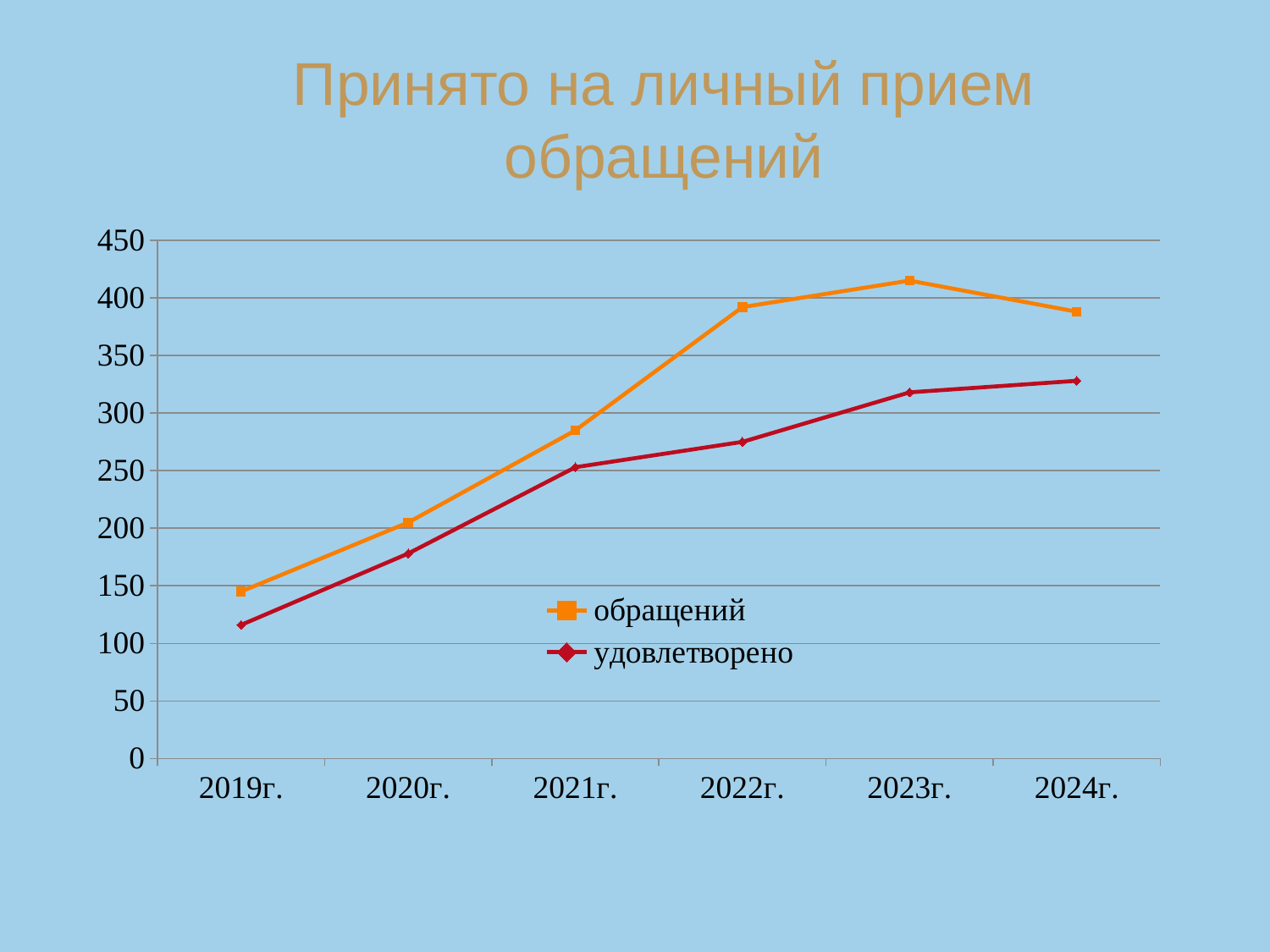
In which year is the value for удовлетворено lowest? 2019г. Does the value for удовлетворено rise or fall from 2019г. to 2024г.? rise What is the title of the chart? Принято на личный прием обращений Is the value for удовлетворено in 2024г. greater or less than 300? greater Is the value for обращений in 2022г. greater or less than 350? greater Is the value for удовлетворено in 2021г. greater or less than 300? less How many years are shown on the x axis? 6 In which year is the value for обращений highest? 2023г. Which series has the larger value in 2022г., обращений or удовлетворено? обращений How many series does the legend list? 2 What kind of chart is shown on the slide? line chart